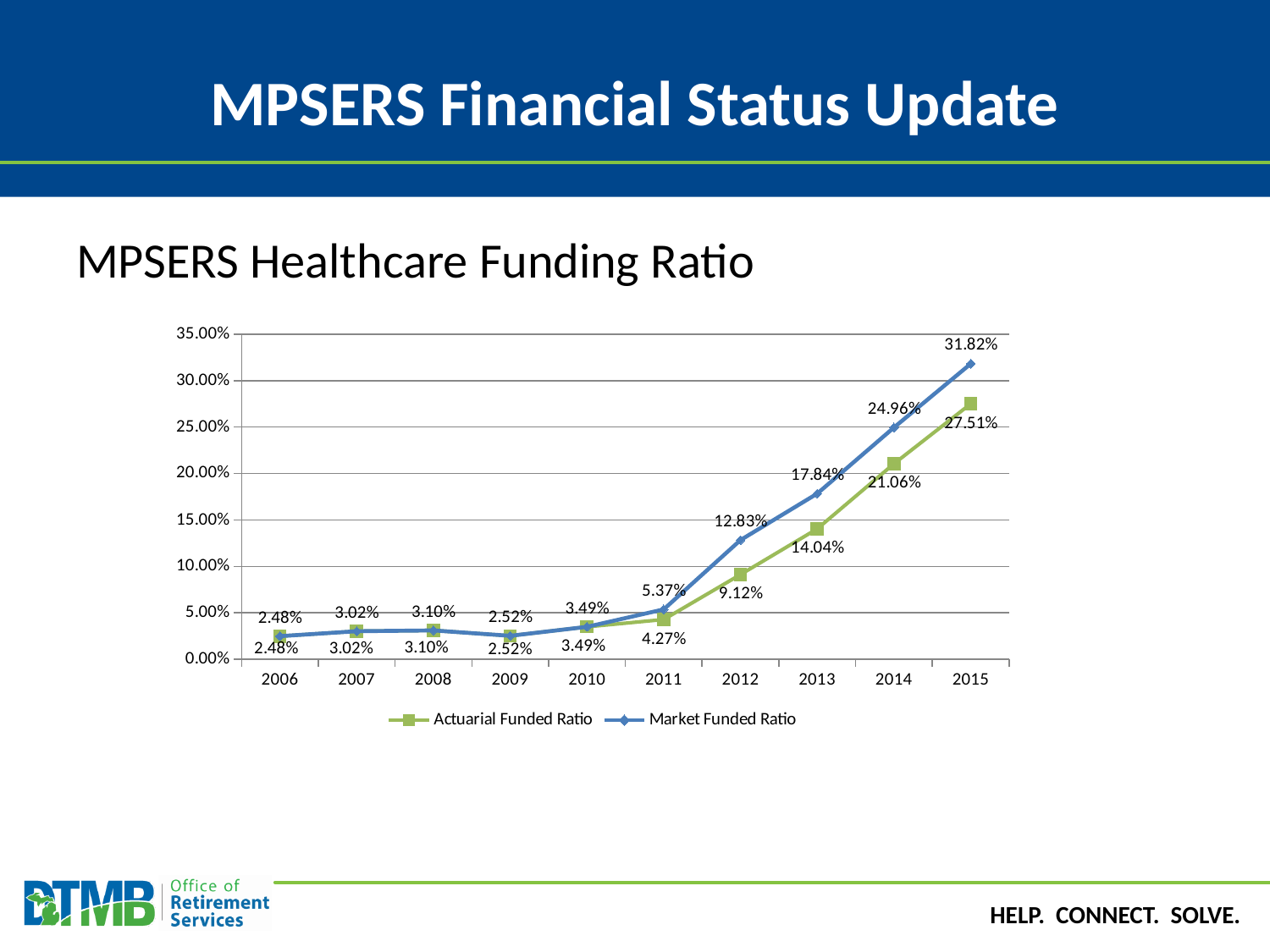
What is the difference between the Market Funded Ratio and the Actuarial Funded Ratio in 2014? 3.90% Do the funding ratios generally rise or fall from 2010 to 2015? rise Which series is drawn with green square markers? Actuarial Funded Ratio How many series does the legend list? 2 How many years are shown on the x axis? 10 What kind of chart is shown on the slide? line chart In which year is the Market Funded Ratio highest? 2015 In which year is the Actuarial Funded Ratio lowest? 2006 What is the Actuarial Funded Ratio in 2013? 14.04% Which is larger in 2012, the Market Funded Ratio or the Actuarial Funded Ratio? Market Funded Ratio What is the Actuarial Funded Ratio in 2011? 4.27% What is the Market Funded Ratio in 2015? 31.82%